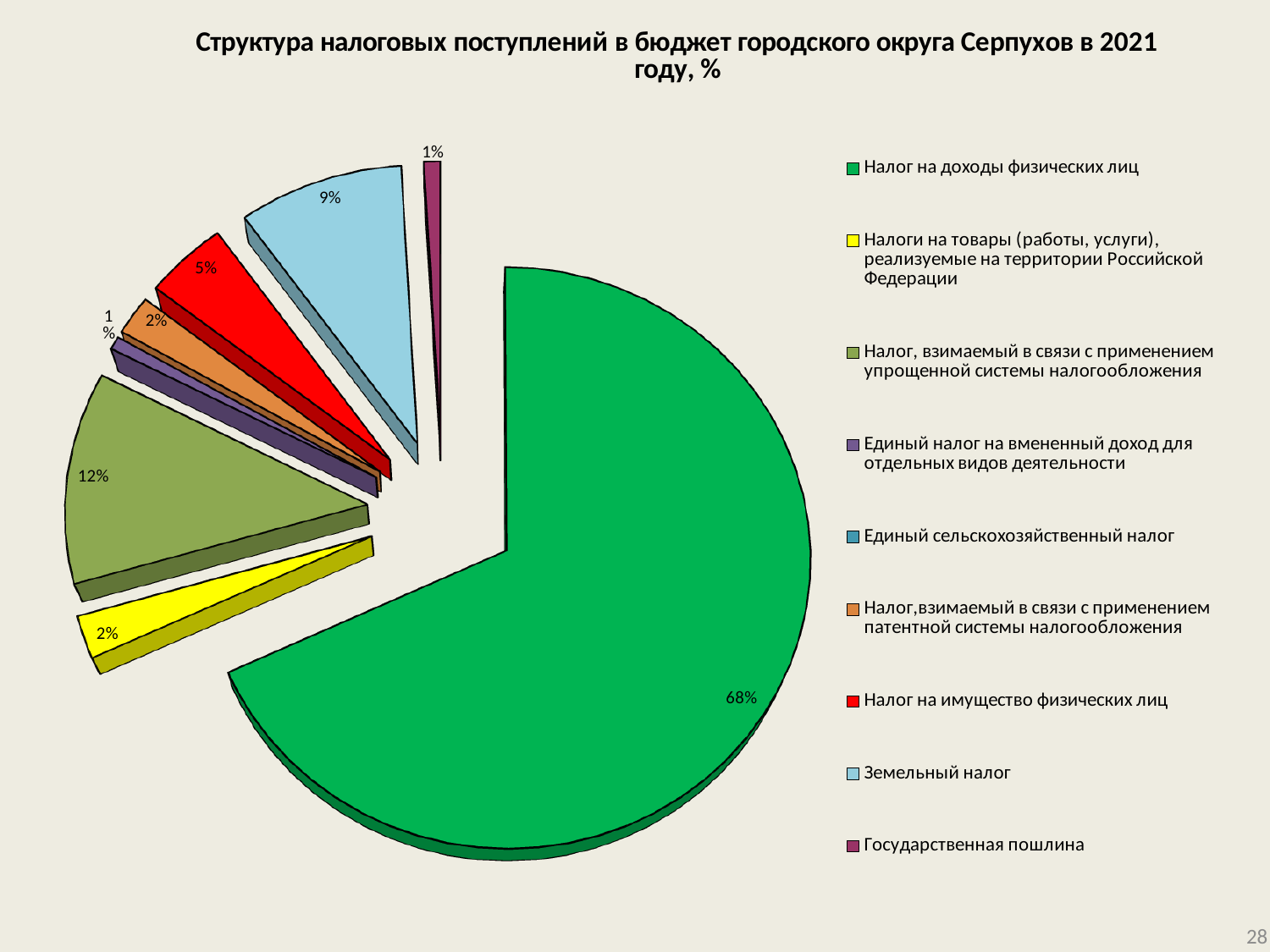
What share is shown for "Налог, взимаемый в связи с применением упрощенной системы налогообложения"? 12% Which category has the largest share of the pie? Налог на доходы физических лиц What share of tax revenue does "Налог на доходы физических лиц" account for? 68% What share is shown for "Налог на имущество физических лиц"? 5% What share is shown for "Государственная пошлина"? 1% Which has the larger share: "Налог на имущество физических лиц" or "Налог,взимаемый в связи с применением патентной системы налогообложения"? Налог на имущество физических лиц What share is shown for "Налоги на товары (работы, услуги), реализуемые на территории Российской Федерации"? 2% How many categories does the legend list? 9 What is the title of the chart? Структура налоговых поступлений в бюджет городского округа Серпухов в 2021 году, % By how many percentage points does the share of "Налог на доходы физических лиц" exceed the share of "Налог, взимаемый в связи с применением упрощенной системы налогообложения"? 56 percentage points What is the difference between the shares of "Налог, взимаемый в связи с применением упрощенной системы налогообложения" and "Налог на имущество физических лиц"? 7 percentage points What type of chart is shown on the slide? Pie chart